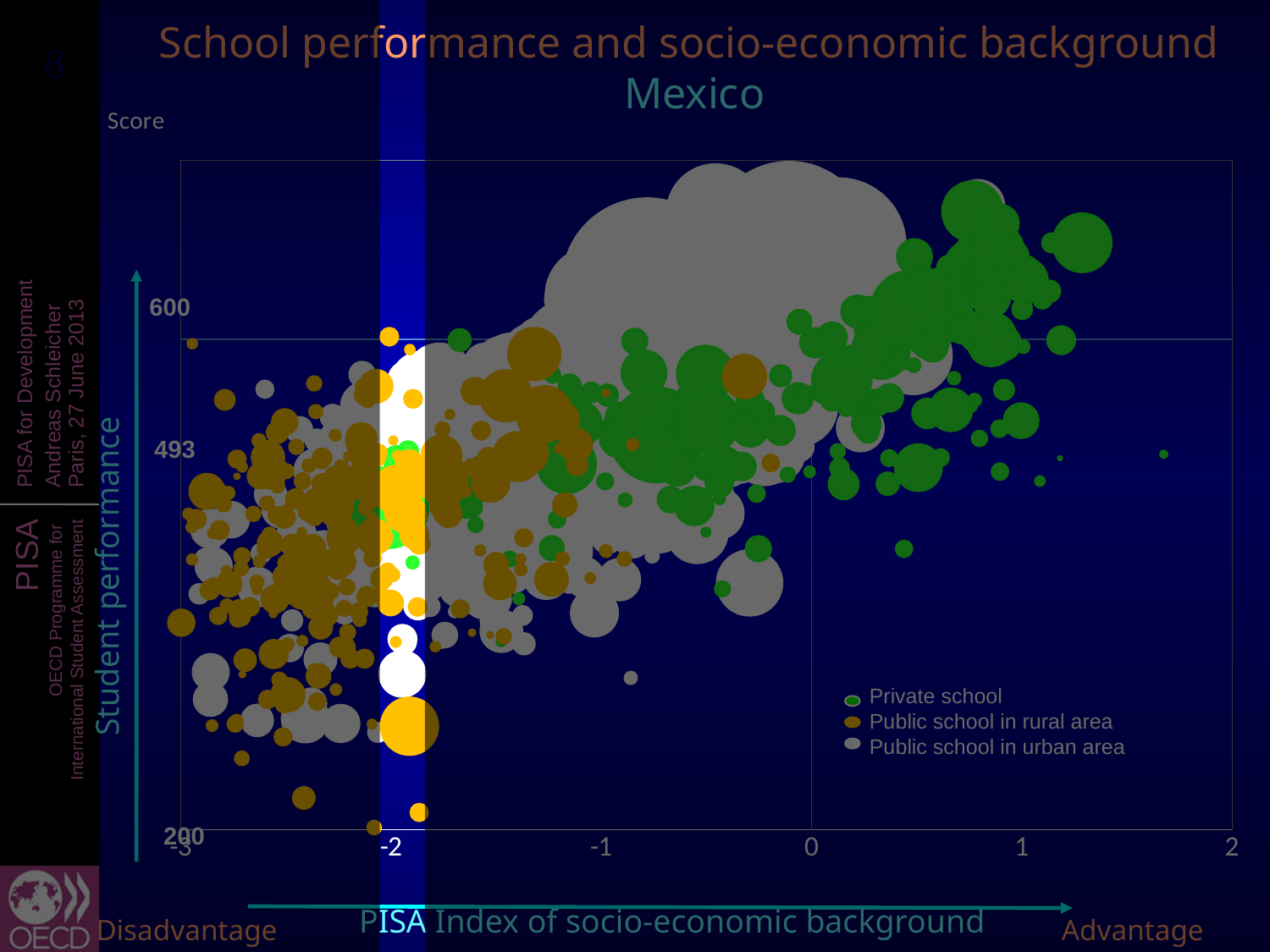
How many series does the legend list? 3 Which series is shown in green? Private school What is the label of the horizontal axis? PISA Index of socio-economic background Which series has the bubbles reaching the highest student performance scores? Private school Does student performance generally rise or fall as the PISA index of socio-economic background increases? rise What kind of chart is shown on the slide? bubble chart Is the score of the private school bubble furthest to the right greater or less than 600? less Is the score of the lowest public school in rural area bubble greater or less than 493? less